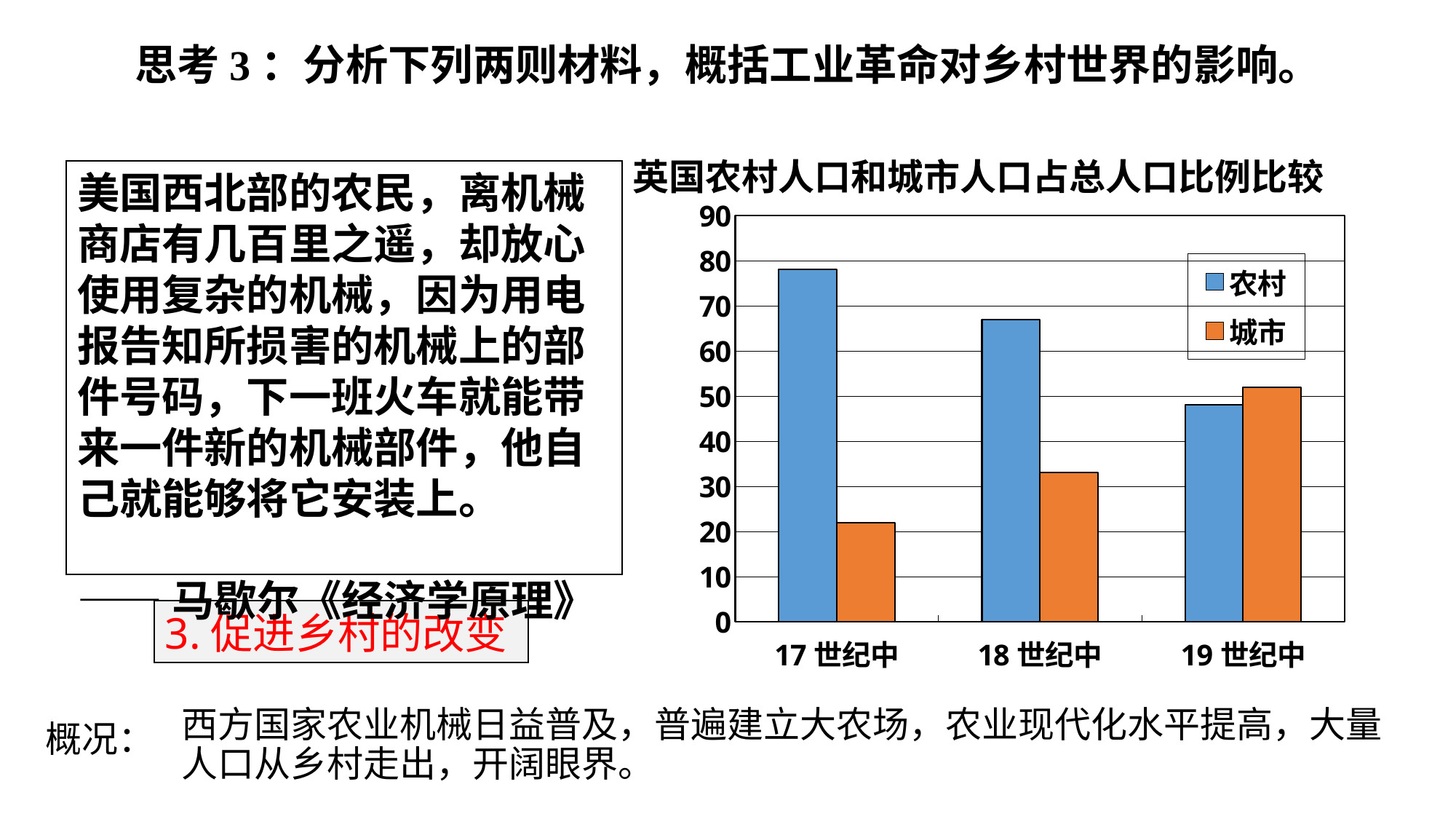
Which category has the lowest value for 城市? 17 世纪中 How many categories are shown on the x axis of the chart? 3 Do the values for 农村 rise or fall from 17 世纪中 to 19 世纪中? fall Which category has the highest value for 城市? 19 世纪中 In 17 世纪中, which is larger, 农村 or 城市? 农村 What kind of chart is shown on the slide? bar chart How many series does the chart legend list? 2 What is the title of the chart? 英国农村人口和城市人口占总人口比例比较 Is the value for 农村 in 18 世纪中 greater or less than 60? greater Is the value for 农村 in 17 世纪中 greater or less than 70? greater Is the value for 城市 in 17 世纪中 greater or less than 30? less Which category has the highest value for 农村? 17 世纪中